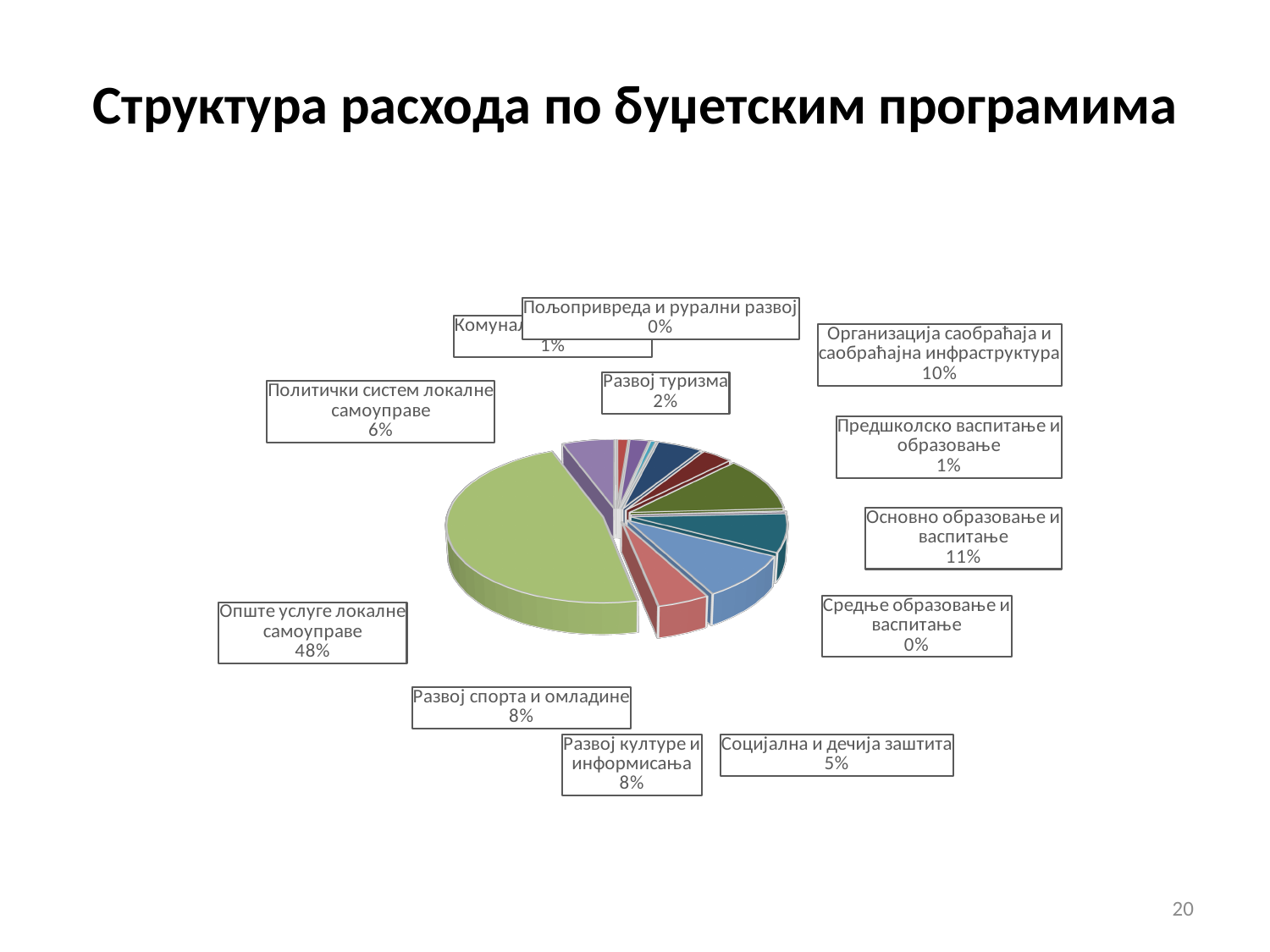
What percentage is shown for Развој туризма? 2% Which is larger, the share for Развој спорта и омладине or the share for Социјална и дечија заштита? Развој спорта и омладине What percentage is shown for Организација саобраћаја и саобраћајна инфраструктура? 10% What share of the pie does Опште услуге локалне самоуправе have? 48% What kind of chart is shown on the slide? pie chart Which category has the largest share of the pie? Опште услуге локалне самоуправе What is the title of the chart on the slide? Структура расхода по буџетским програмима What percentage is shown for Основно образовање и васпитање? 11% What is the difference in percentage points between Опште услуге локалне самоуправе and Основно образовање и васпитање? 37 How many categories are labelled on the pie chart? 12 What percentage is shown for Политички систем локалне самоуправе? 6% What percentage is shown for Социјална и дечија заштита? 5%